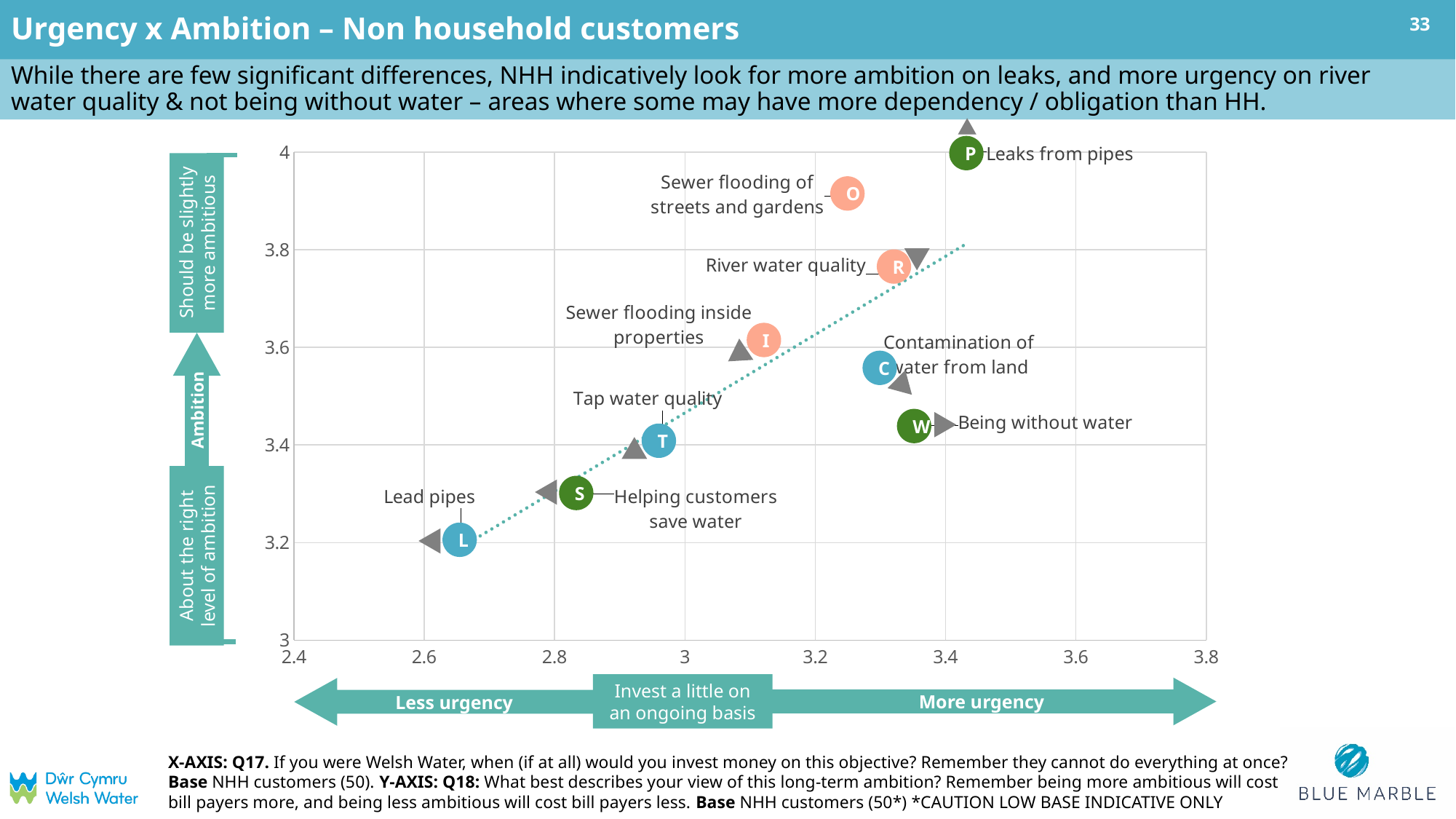
Is the ambition (y axis) value for Tap water quality greater or less than 3.6? less Which has the higher ambition score: Sewer flooding of streets and gardens or Being without water? Sewer flooding of streets and gardens Which objective has the lowest ambition score (lowest on the y axis)? Lead pipes Which has the higher urgency score: Lead pipes or Contamination of water from land? Contamination of water from land What kind of chart is shown on the slide? Scatter chart How many objectives are plotted as points on the chart? 9 Is the urgency (x axis) value for Leaks from pipes greater or less than 3.4? greater Along the dotted trend line, does ambition rise or fall as urgency increases? Rises Is the urgency (x axis) value for Helping customers save water greater or less than 3? less Which objective has the lowest urgency score (furthest left on the x axis)? Lead pipes What is the title of the slide containing the chart? Urgency x Ambition – Non household customers Which objective has the highest ambition score (highest on the y axis)? Leaks from pipes